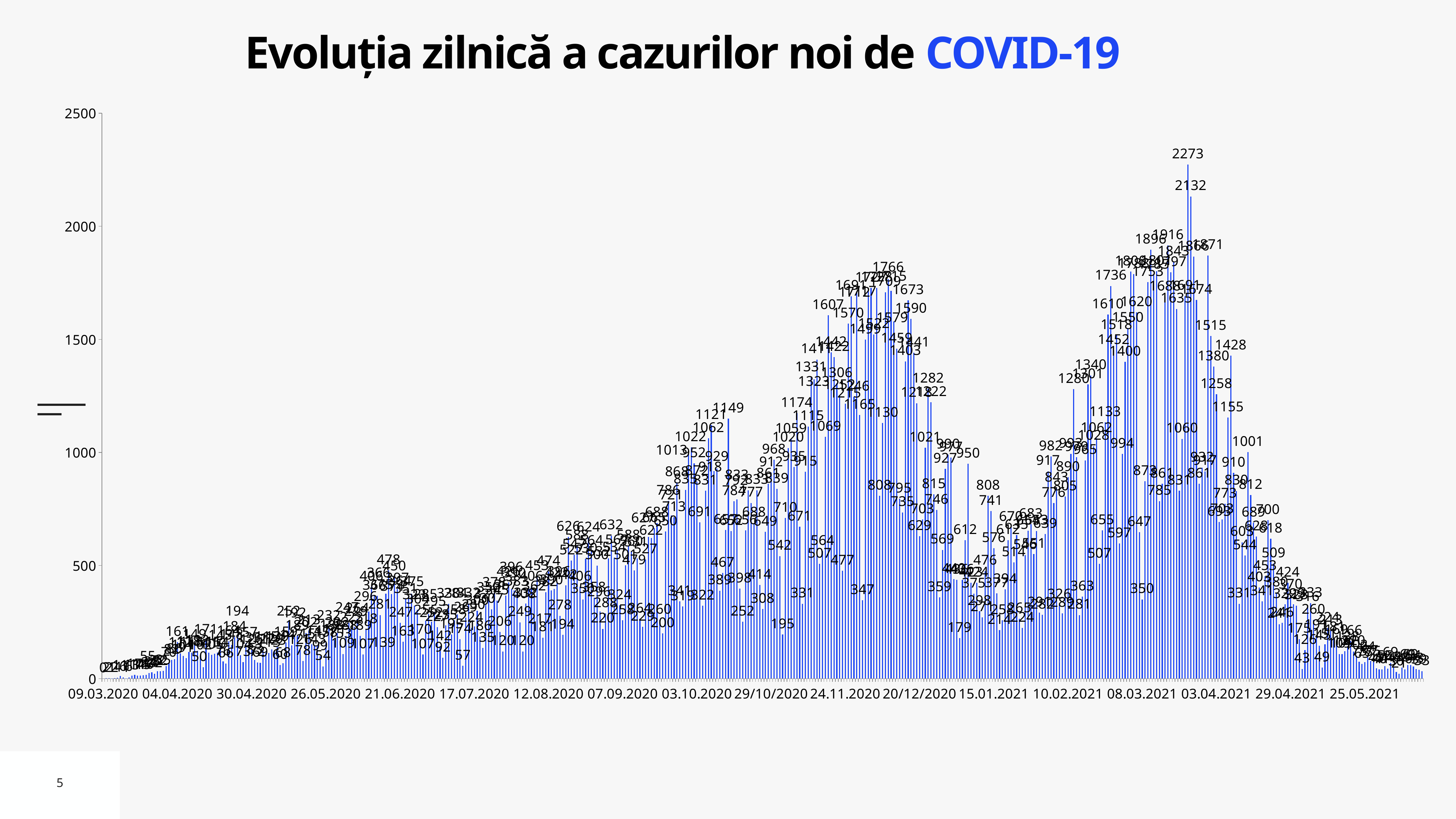
What is the highest daily value labelled on the chart? 2273 What kind of chart is shown on the slide? bar chart What is the last date label on the horizontal axis? 25.05.2021 Do the daily values rise or fall between 03.04.2021 and 25.05.2021? fall What is the difference between the two highest labelled values, 2273 and 2132? 141 What is the second highest daily value labelled on the chart, next to the 2273 peak? 2132 What is the title of the chart? Evoluția zilnică a cazurilor noi de COVID-19 Is the highest bar in the wave around 24.11.2020 higher or lower than the highest bar in the wave around 03.04.2021? lower What is the first date label on the horizontal axis? 09.03.2020 What is the highest value shown on the vertical axis? 2500 Is the highest bar on the chart greater or less than 2000? greater Are the bars at the start of the chart, around 09.03.2020, greater or less than 500? less